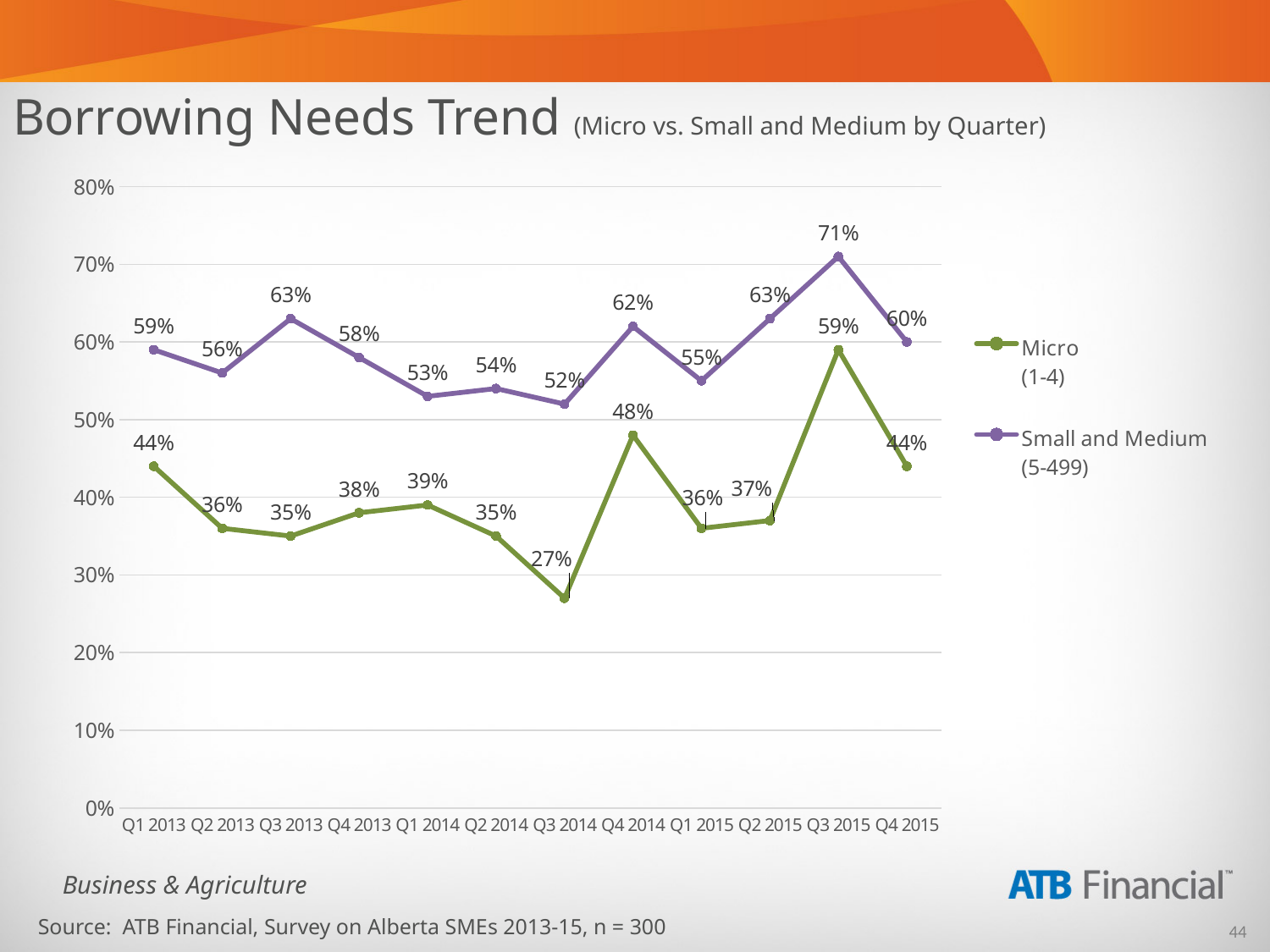
How many series does the legend list? 2 What is the value for Small and Medium (5-499) in Q3 2015? 71% What is the value for Micro (1-4) in Q3 2014? 27% Does the Micro (1-4) series rise or fall from Q3 2015 to Q4 2015? Fall What is the difference between Small and Medium (5-499) and Micro (1-4) in Q3 2014? 25% Which series has the higher value in Q1 2013, Micro (1-4) or Small and Medium (5-499)? Small and Medium (5-499) What is the value for Micro (1-4) in Q4 2015? 44% What type of chart is shown on the slide? Line chart In which quarter does the Micro (1-4) series reach its lowest value? Q3 2014 How many quarters are plotted along the x axis? 12 In which quarter does the Small and Medium (5-499) series reach its highest value? Q3 2015 What is the title of the chart on the slide? Borrowing Needs Trend (Micro vs. Small and Medium by Quarter)